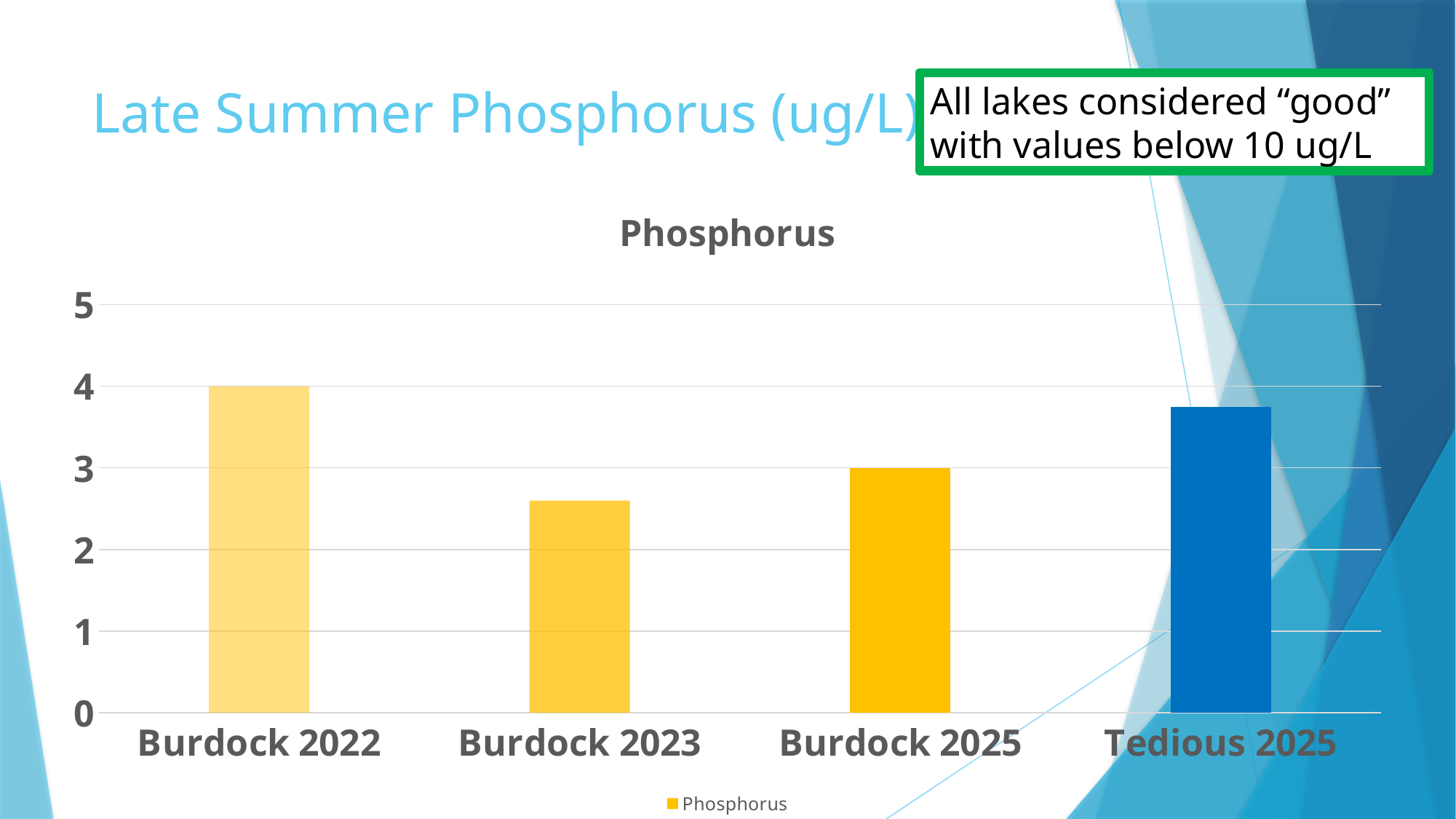
Is the value for Burdock 2023 greater or less than 3? less Which has a larger phosphorus value, Tedious 2025 or Burdock 2025? Tedious 2025 Which category has the lowest phosphorus value? Burdock 2023 Which category has the highest phosphorus value? Burdock 2022 Is the value for Tedious 2025 greater or less than 3? greater How many series does the chart legend list? 1 What type of chart is shown on the slide? bar chart What is the title shown above the chart? Phosphorus How many categories are shown on the x axis of the chart? 4 What is the phosphorus value for Burdock 2025? 3 What is the difference between the phosphorus values for Burdock 2022 and Burdock 2025? 1 What is the phosphorus value for Burdock 2022? 4